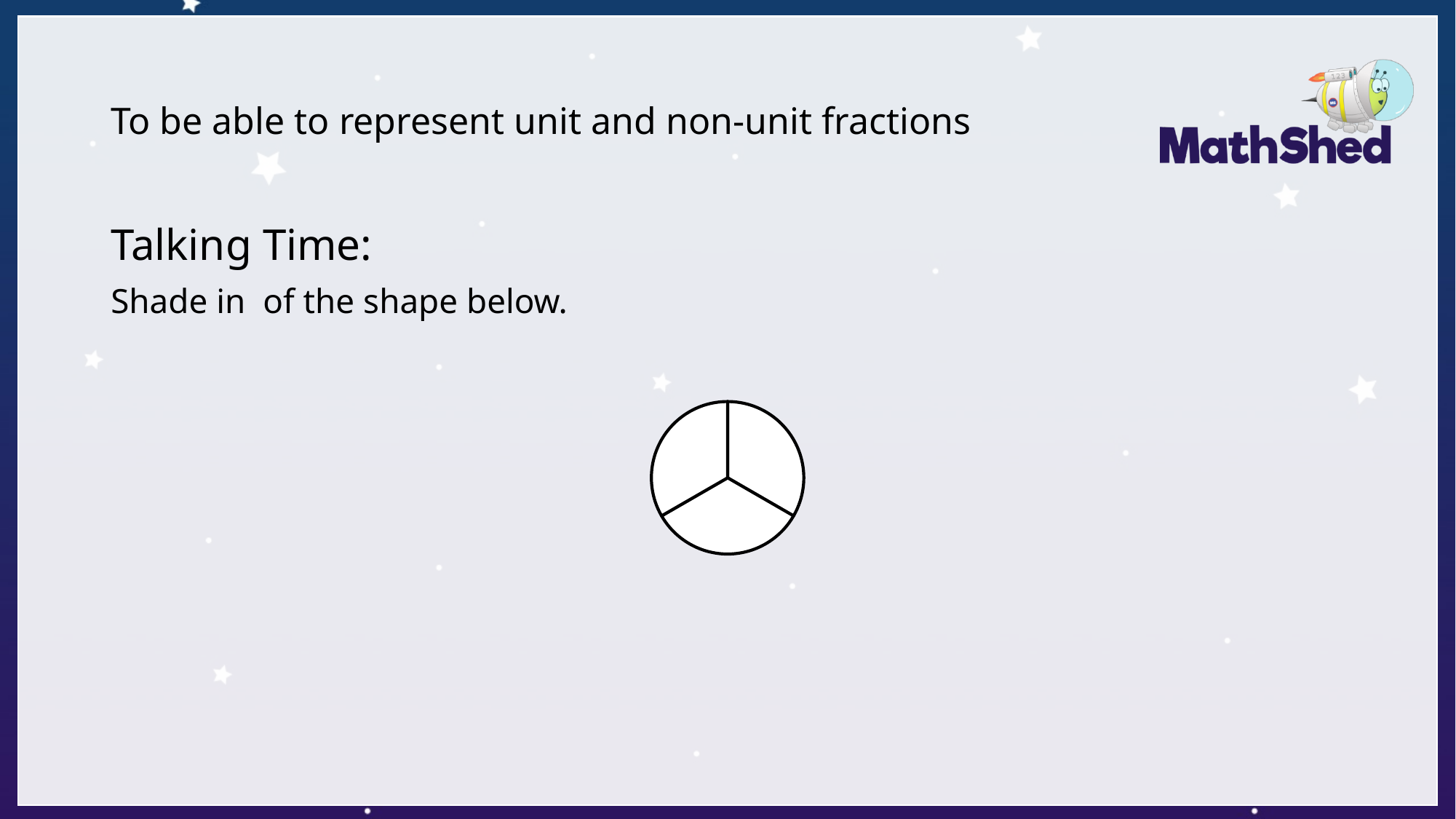
What shape is divided into parts on the slide? A circle How many equal sections is the circle on the slide divided into? 3 Are any of the sections of the circle shaded? No What fraction of the circle does each section represent? 1/3